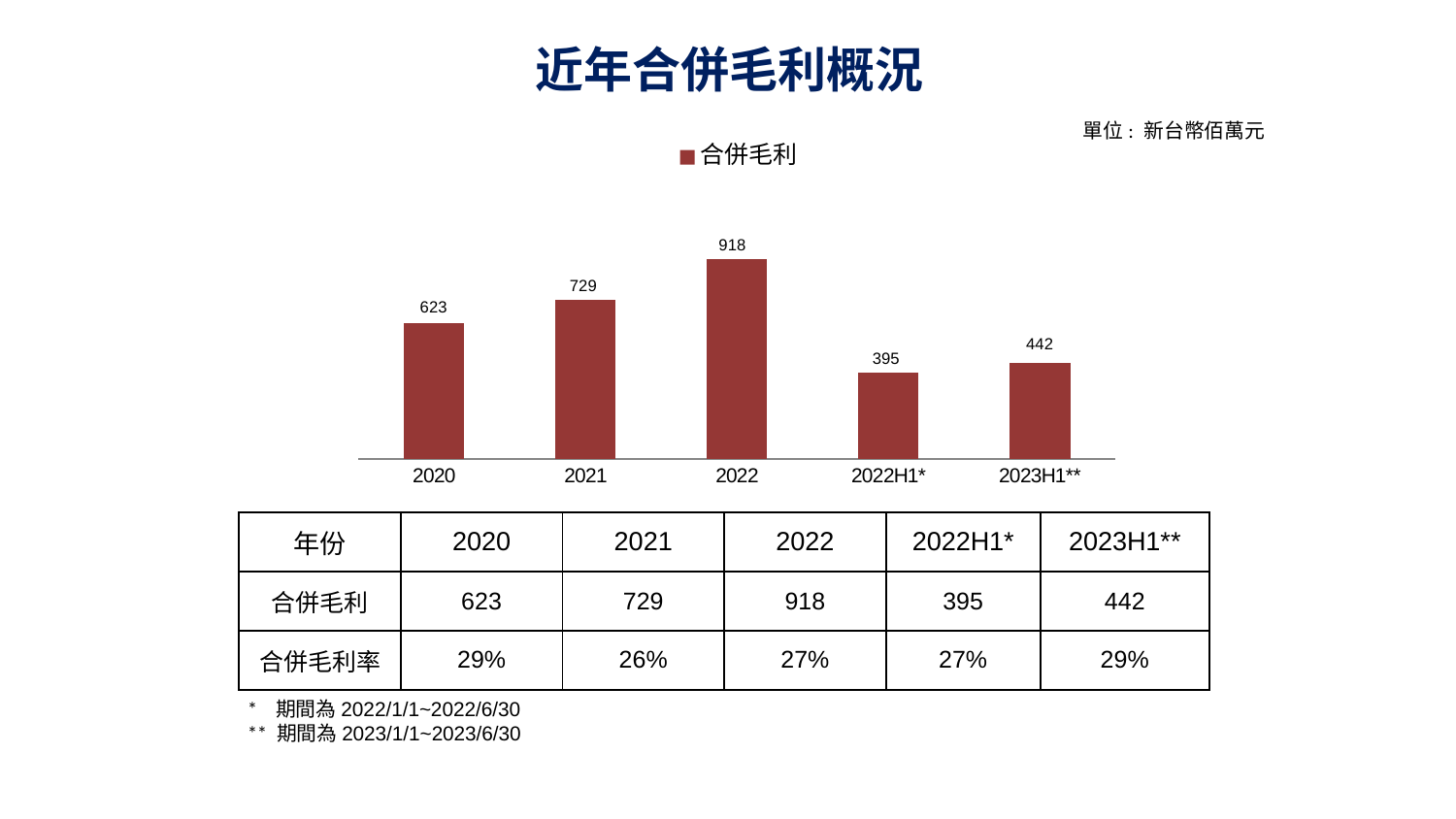
What is the difference between the 合併毛利 values for 2023H1** and 2022H1*? 47 Which category has the highest 合併毛利 value? 2022 What is the difference between the 合併毛利 values for 2022 and 2021? 189 Which category has the lowest 合併毛利 value? 2022H1* Which is larger, the 合併毛利 value for 2021 or for 2020? 2021 What is the 合併毛利 value for 2023H1**? 442 How many categories are shown on the x axis of the chart? 5 What is the 合併毛利 value for 2022? 918 What kind of chart is shown on the slide? bar chart What is the series name shown in the chart legend? 合併毛利 What is the 合併毛利 value for 2020? 623 How many series does the chart legend list? 1